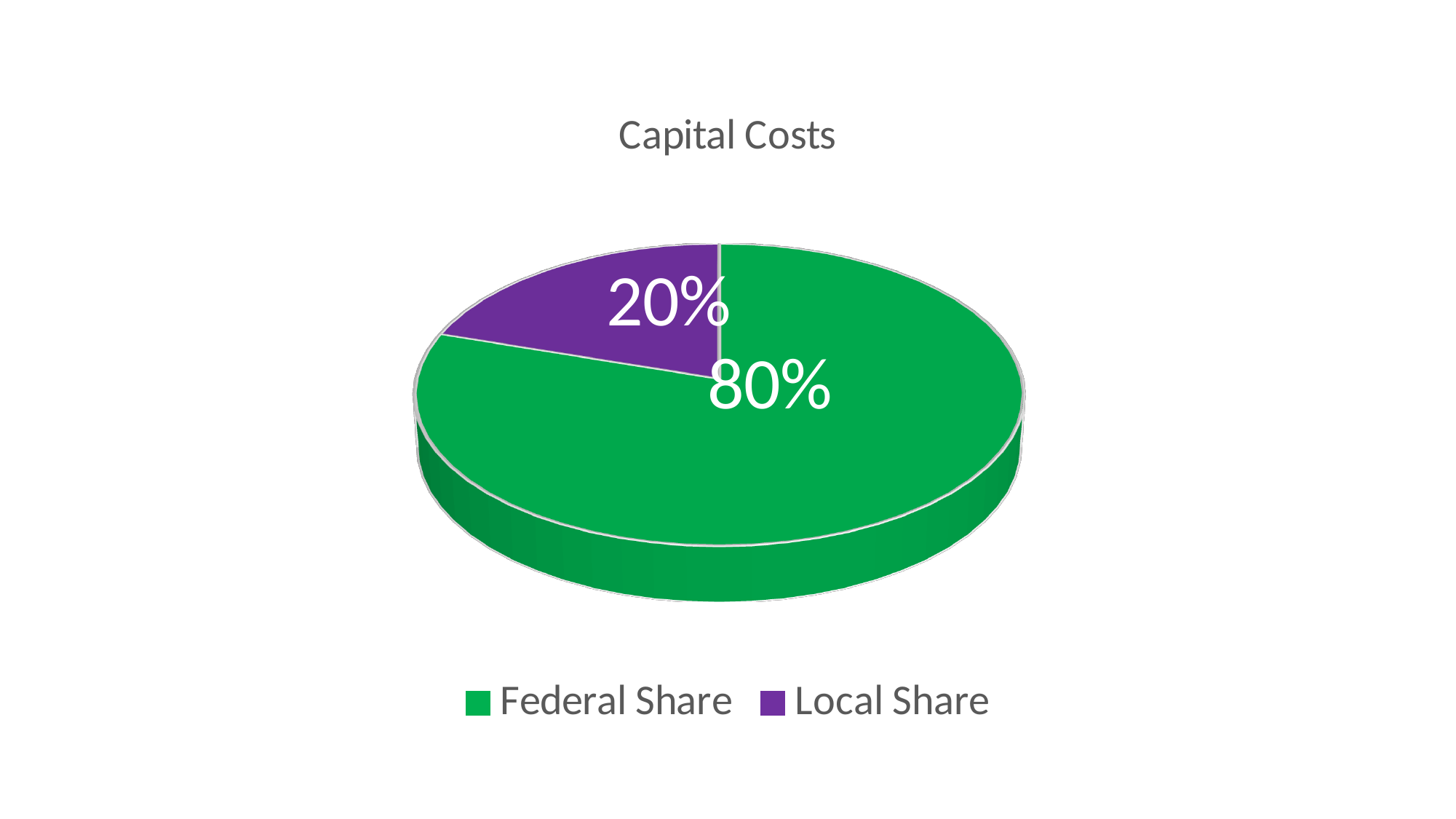
Which is larger, the Federal Share or the Local Share? Federal Share What is the difference in percentage points between the Federal Share and the Local Share? 60 percentage points How many slices does the pie chart have? 2 What is the title of the chart? Capital Costs How many entries does the legend list? 2 Which slice of the pie is the largest? Federal Share Which slice of the pie is the smallest? Local Share What kind of chart is shown on the slide? pie chart What share of Capital Costs is the Local Share? 20% What share of Capital Costs is the Federal Share? 80% What colour is the Local Share slice? purple